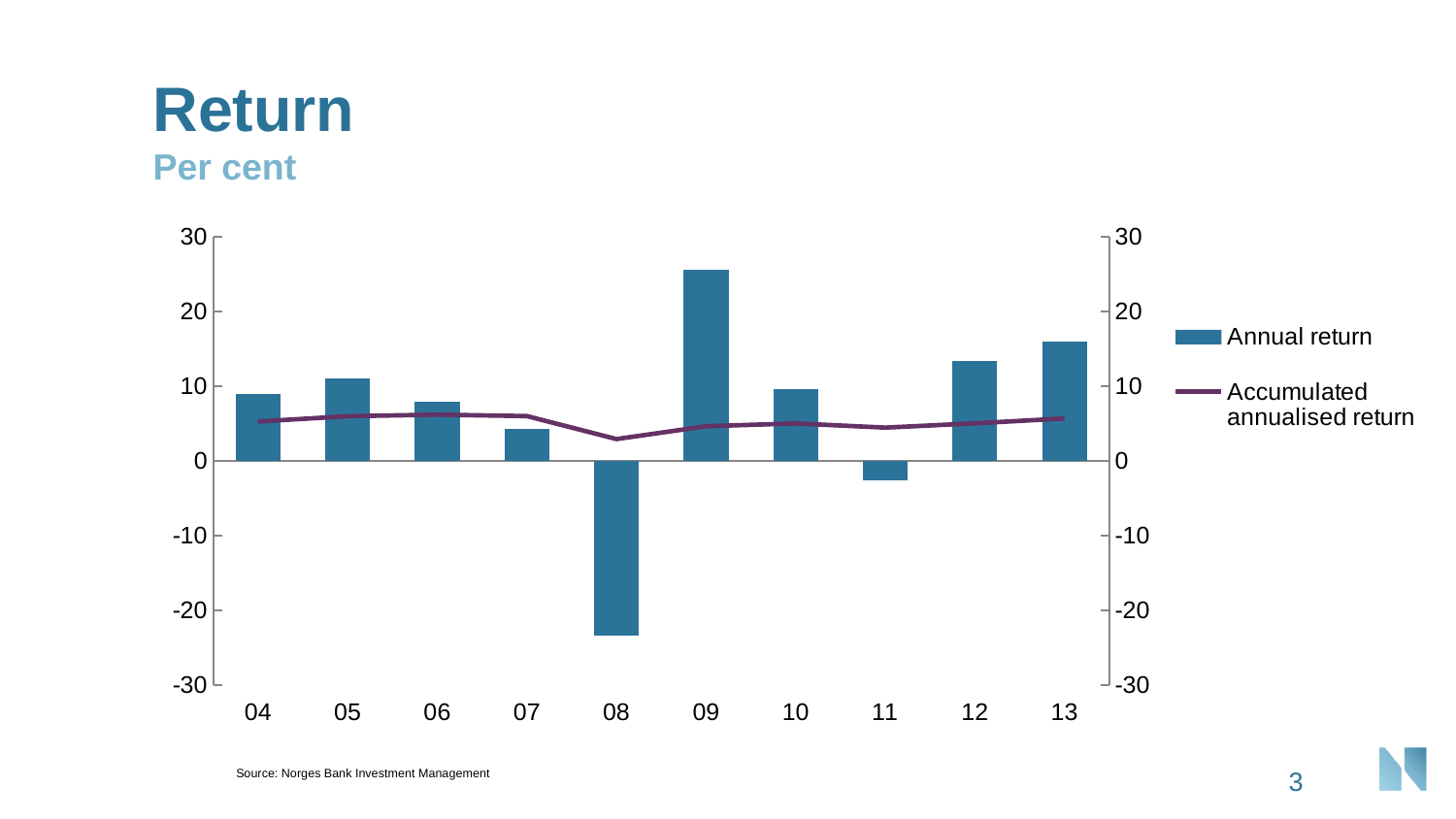
Which year has the larger annual return, 12 or 07? 12 Is the annual return for 13 greater or less than 10? greater What is the title of the chart? Return Which year has the lowest annual return? 08 What kind of chart is shown on the slide? A bar chart with a line series Does the accumulated annualised return line rise or fall from 08 to 13? rise Which year has the highest annual return? 09 Is the annual return for 09 greater or less than 20? greater How many series does the legend list? 2 Is the annual return for 11 greater or less than 0? less How many years are shown on the x axis? 10